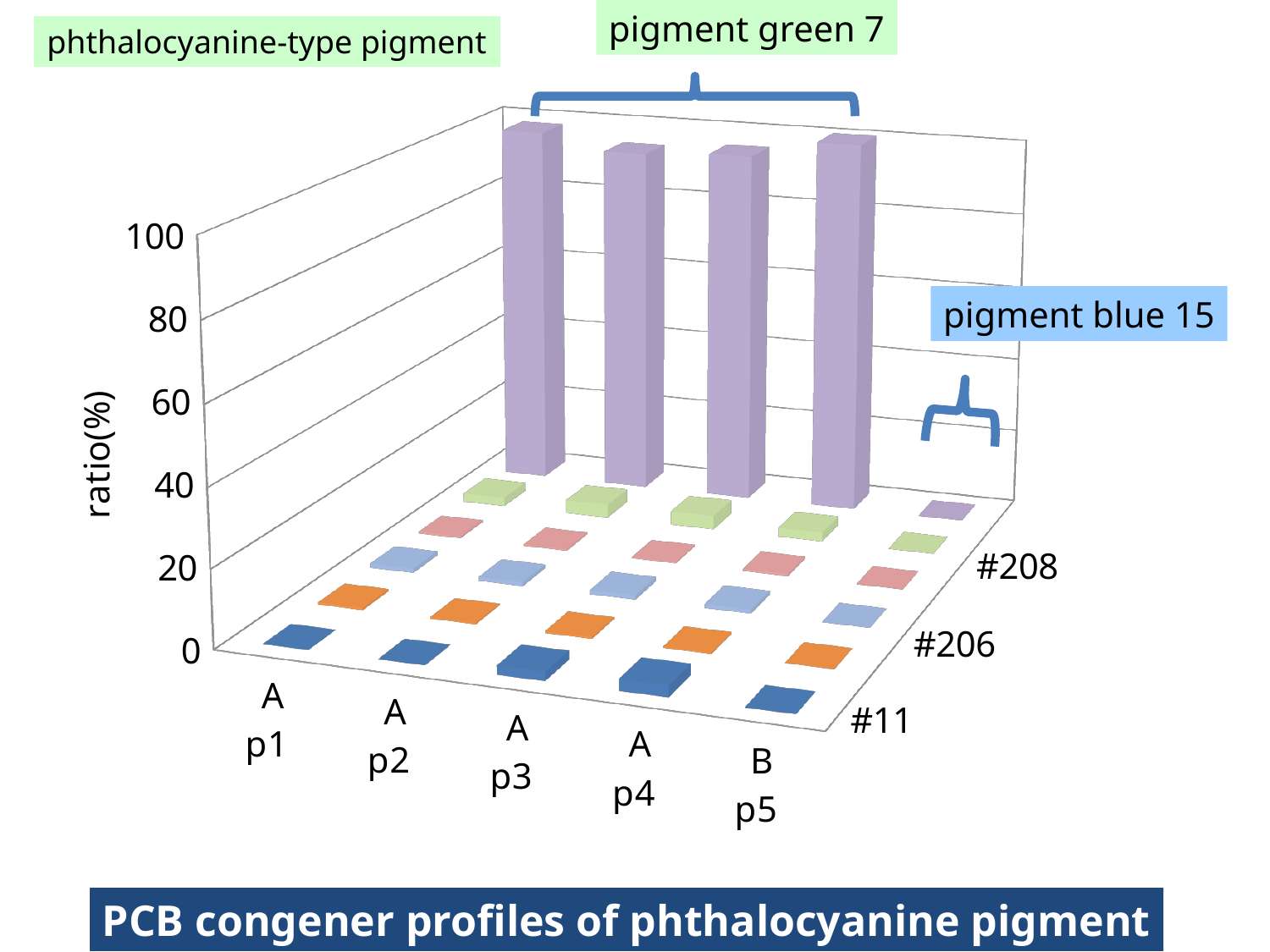
What is the highest tick value shown on the y axis? 100 Is the value of the #11 bar for A p1 greater or less than 20? less Is the value of the tallest (purple, back-row) bar for A p1 greater or less than 60? greater Is the value of the #206 bar for A p3 greater or less than 20? less How many sample categories are shown along the x axis of the chart? 5 For A p2, which is larger: the back-row (purple) bar or the #11 bar? the back-row (purple) bar What kind of chart is shown on the slide? bar chart Which sample has the lowest value in the back-row (purple) series? B p5 What is the title shown beneath the chart? PCB congener profiles of phthalocyanine pigment What is the title of the y axis of the chart? ratio(%)